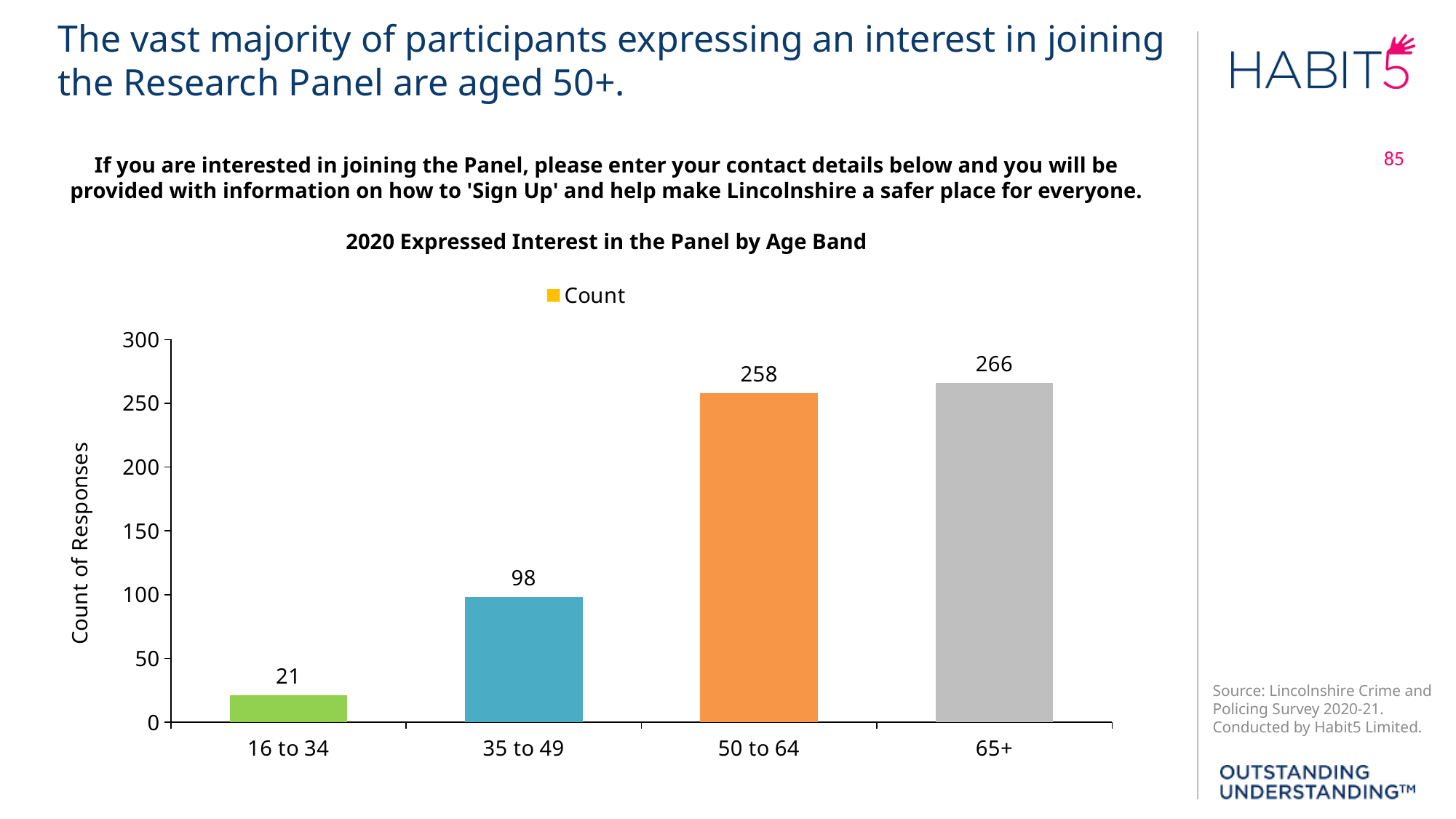
What is the count of responses for the 65+ age band? 266 What is the title of the chart? 2020 Expressed Interest in the Panel by Age Band What is the difference in count between the 65+ and 50 to 64 age bands? 8 Which age band has the highest count of responses? 65+ What is the count of responses for the 35 to 49 age band? 98 How many age bands are shown on the chart? 4 Which age band has the lowest count of responses? 16 to 34 What kind of chart is shown on the slide? Bar chart What is the count of responses for the 50 to 64 age band? 258 What is the count of responses for the 16 to 34 age band? 21 Which age band has a larger count, 35 to 49 or 50 to 64? 50 to 64 What is the difference in count between the 35 to 49 and 16 to 34 age bands? 77